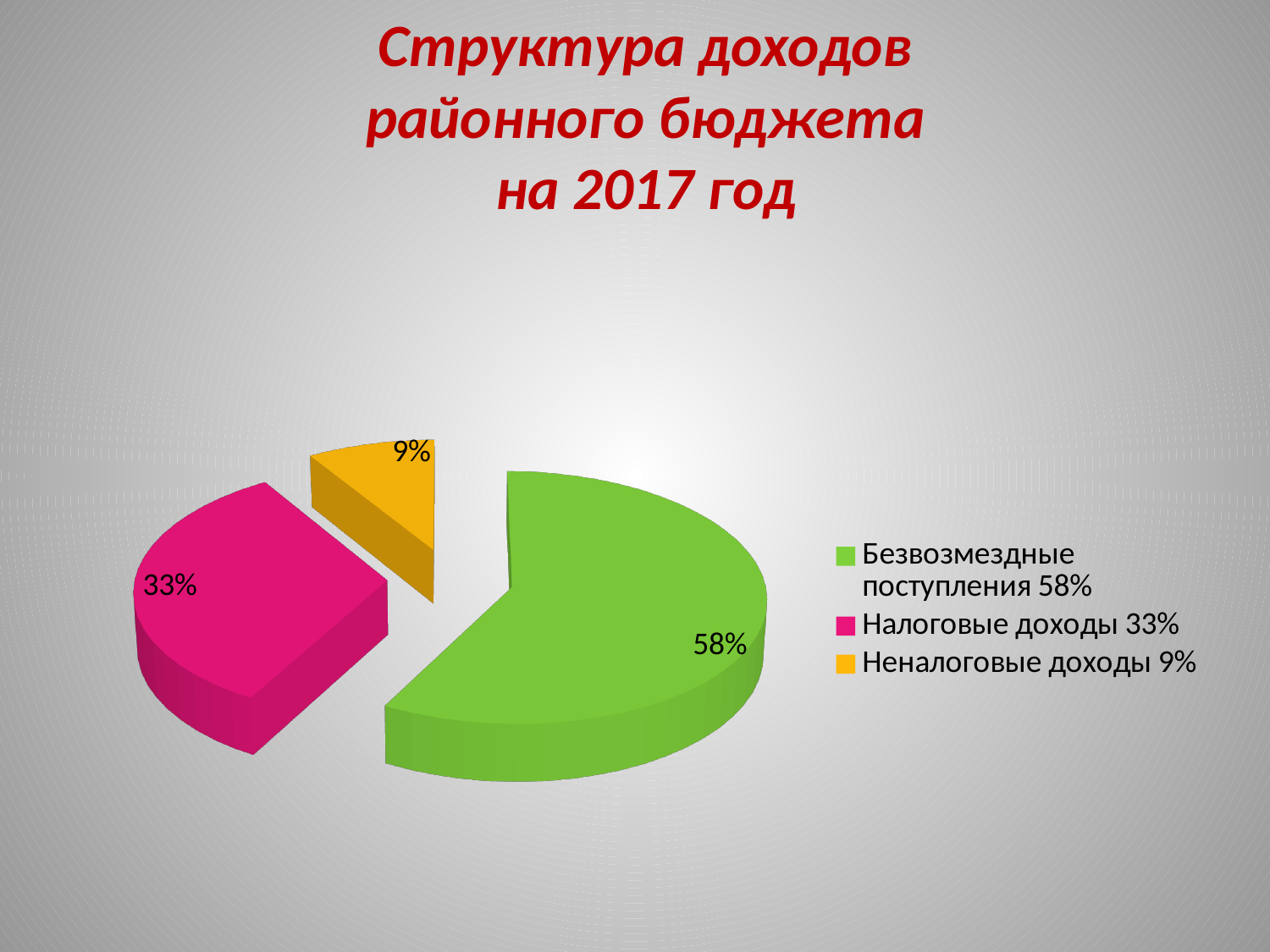
What share of the pie does Неналоговые доходы have? 9% Which is larger, Налоговые доходы or Неналоговые доходы? Налоговые доходы What kind of chart is shown on the slide? pie chart What colour is the slice for Налоговые доходы? pink What is the difference in percentage points between Безвозмездные поступления and Налоговые доходы? 25 What share of the pie does Безвозмездные поступления have? 58% What share of the pie does Налоговые доходы have? 33% Which category has the smallest slice of the pie? Неналоговые доходы What is the title of the slide? Структура доходов районного бюджета на 2017 год What is the difference in percentage points between Налоговые доходы and Неналоговые доходы? 24 Which category has the largest slice of the pie? Безвозмездные поступления How many slices does the pie chart have? 3